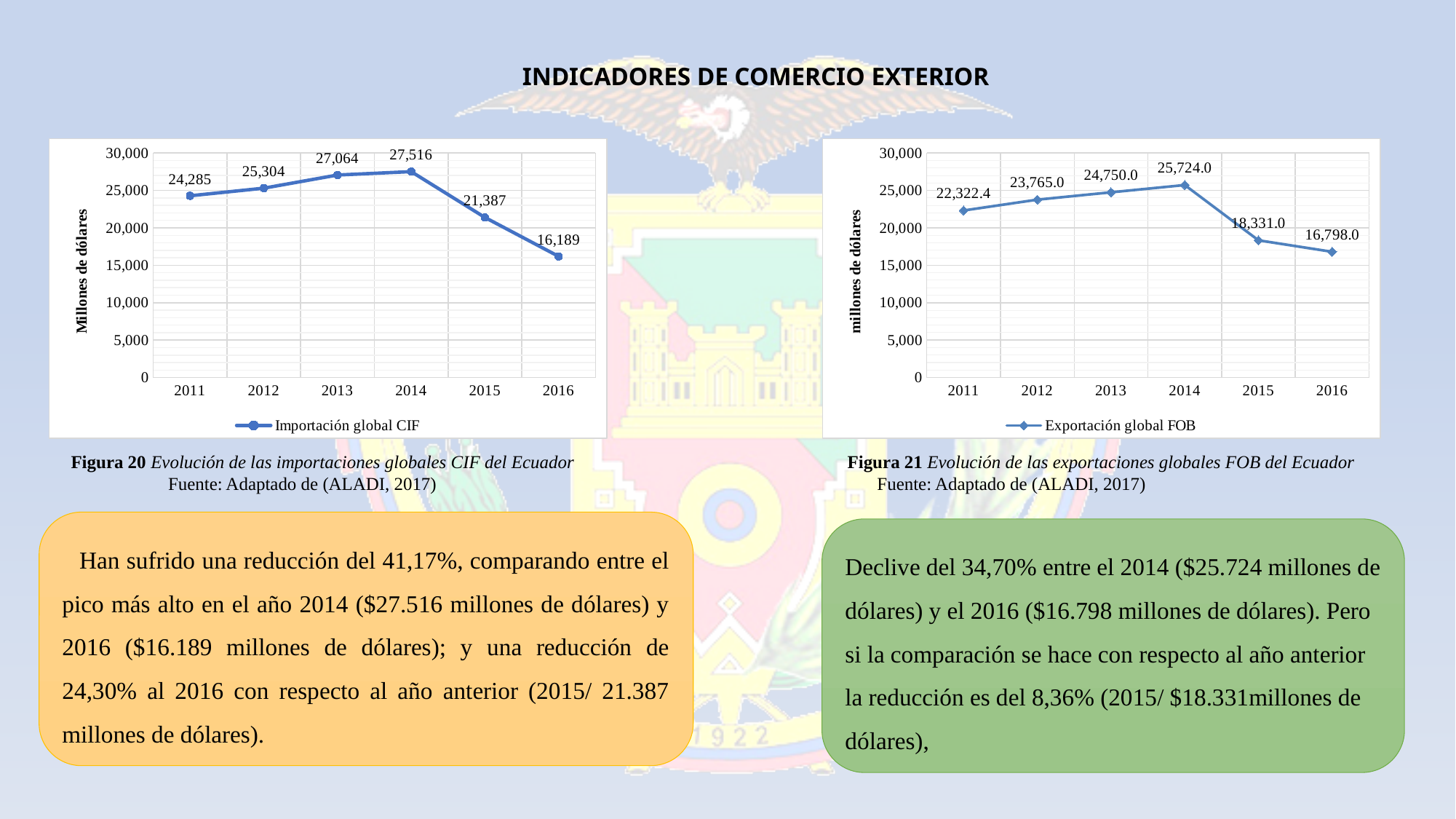
In the right chart (Exportación global FOB), what is the value for 2011? 22,322.4 What is the y-axis label of the left chart (Importación global CIF)? Millones de dólares In the left chart (Importación global CIF), which year has the lowest value? 2016 In the left chart (Importación global CIF), do the values rise or fall from 2014 to 2016? Fall In the right chart (Exportación global FOB), is the value for 2013 greater or less than 20,000? greater In the left chart (Importación global CIF), which is larger, the value for 2012 or the value for 2015? 2012 In the left chart (Importación global CIF), what is the value for 2014? 27,516 What type of chart is the right chart (Exportación global FOB)? Line chart In the left chart (Importación global CIF), what is the difference between the 2014 and 2016 values? 11,327 In the right chart (Exportación global FOB), what is the difference between the 2015 and 2016 values? 1,533.0 How many years are plotted in the left chart (Importación global CIF)? 6 In the right chart (Exportación global FOB), which year has the highest value? 2014